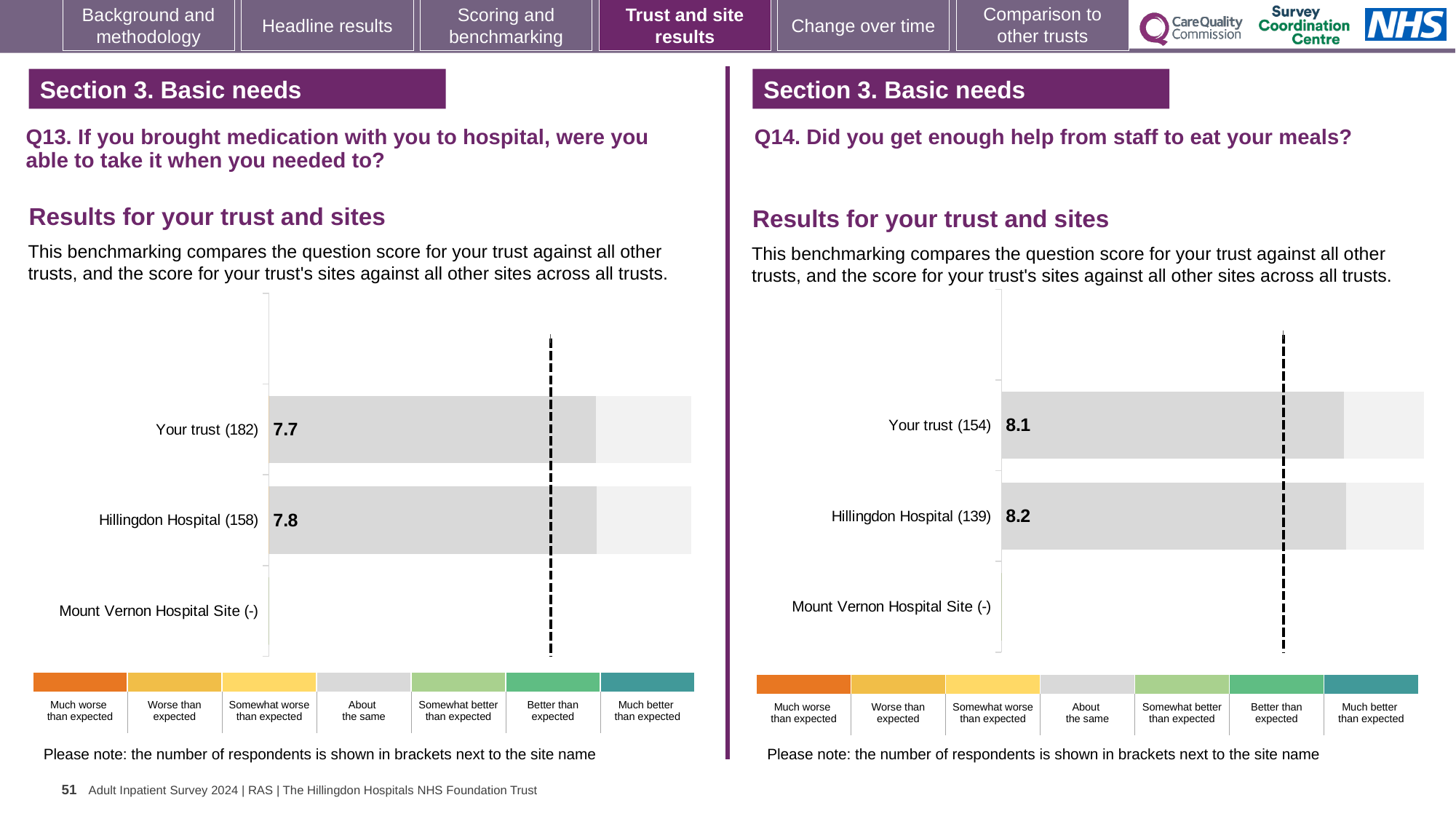
On the Q13 chart (left), what is the score for Your trust? 7.7 On the Q13 chart (left), which site has no score shown (marked with a dash)? Mount Vernon Hospital Site On the Q13 chart (left), what is the difference between the Hillingdon Hospital score and the Your trust score? 0.1 How many categories (rows) are listed on the Q13 chart (left)? 3 On the Q14 chart (right), which has the higher score, Your trust or Hillingdon Hospital? Hillingdon Hospital On the Q13 chart (left), how many respondents are shown in brackets for Your trust? 182 On the Q14 chart (right), what is the score for Hillingdon Hospital? 8.2 What kind of chart is used on the Q14 chart (right)? Bar chart On the Q14 chart (right), how many respondents are shown in brackets for Hillingdon Hospital? 139 On the Q13 chart (left), what is the score for Hillingdon Hospital? 7.8 On the Q14 chart (right), what is the difference between the Hillingdon Hospital score and the Your trust score? 0.1 On the Q14 chart (right), what is the score for Your trust? 8.1